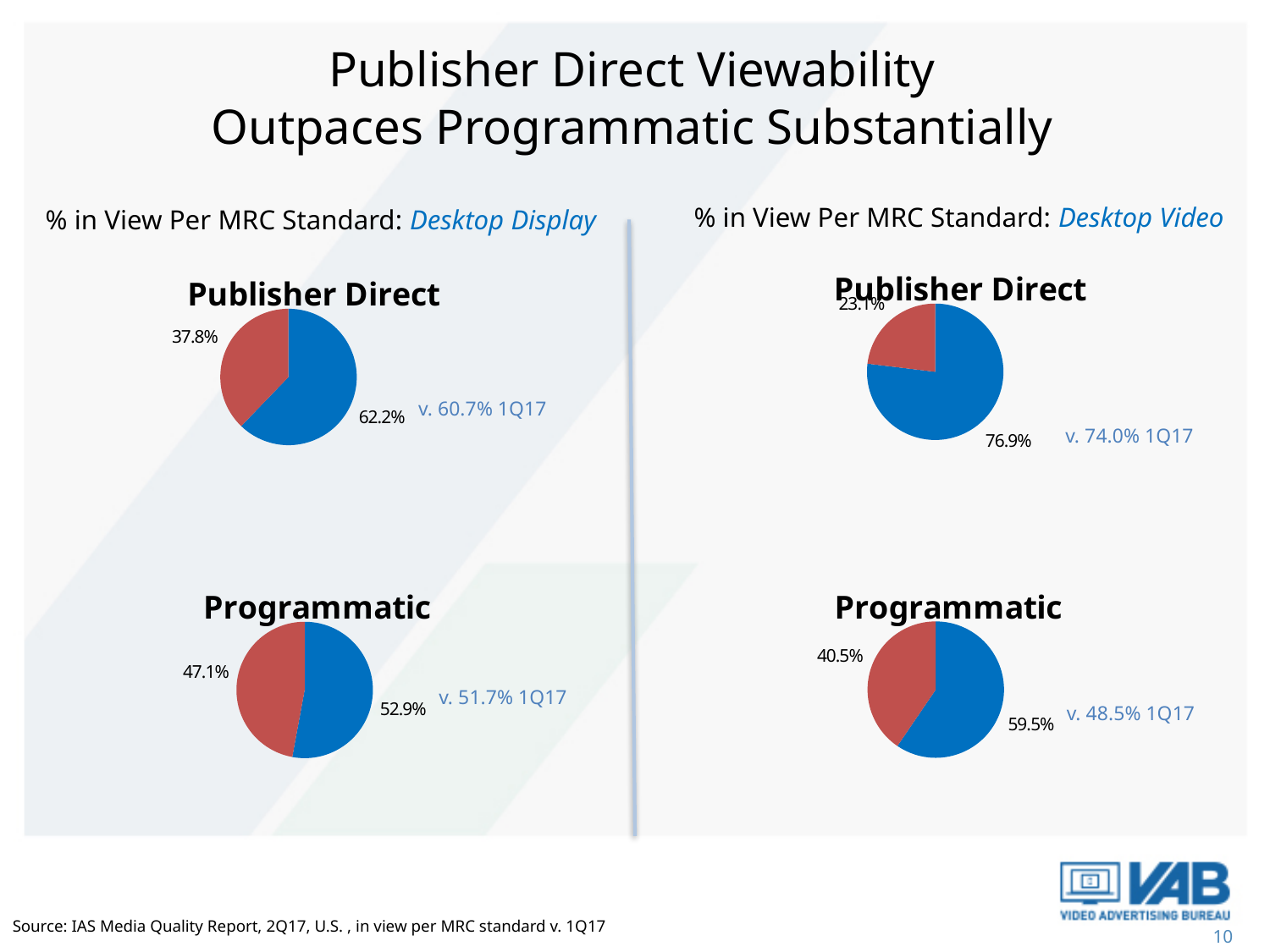
What kind of charts are shown on the slide? Pie charts In the Desktop Display Publisher Direct pie chart, what is the value of the red slice? 37.8% In the Desktop Display Programmatic pie chart, what is the value of the blue slice? 52.9% Across all four pie charts, which chart has the largest blue slice? Desktop Video Publisher Direct How many slices does each pie chart on the slide have? 2 In the Desktop Video Publisher Direct pie chart, what share of the pie is the red slice? 23.1% Which is larger: the blue slice in the Desktop Display Publisher Direct pie chart or the blue slice in the Desktop Display Programmatic pie chart? Desktop Display Publisher Direct In the Desktop Video Programmatic pie chart, what is the value of the red slice? 40.5% In the Desktop Display Publisher Direct pie chart, what is the value of the blue slice? 62.2% In the Desktop Video Publisher Direct pie chart, what is the value of the blue slice? 76.9% How many pie charts are on the slide? 4 What is the difference between the blue slice in the Desktop Video Publisher Direct pie chart and the blue slice in the Desktop Video Programmatic pie chart? 17.4%